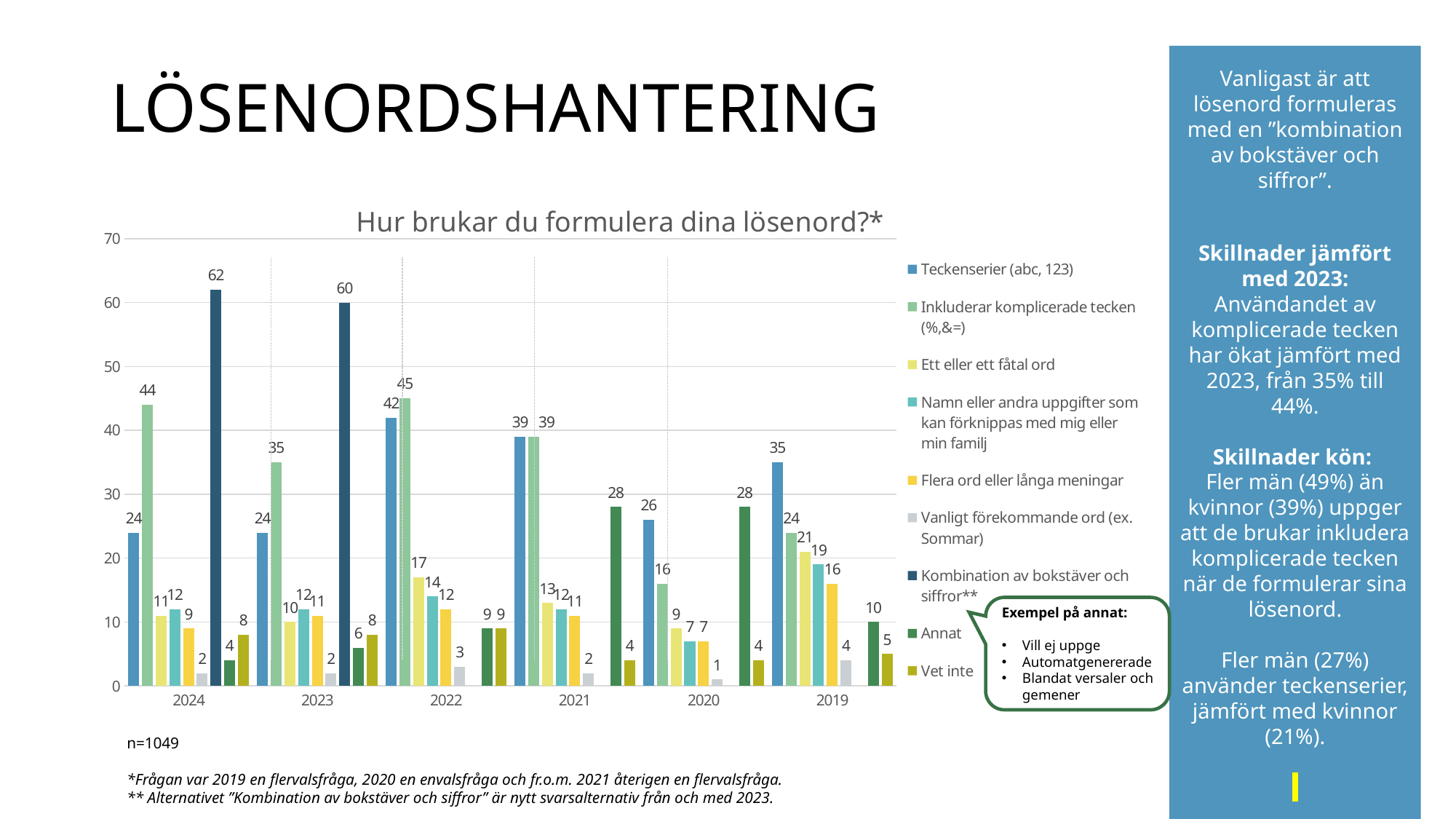
What is the value for 'Inkluderar komplicerade tecken' in 2023? 35 What is the title of the chart? Hur brukar du formulera dina lösenord?* Is the value for 'Kombination av bokstäver och siffror' in 2023 greater or less than 50? greater What type of chart is shown on the slide? bar chart How many series does the legend list? 9 Which year has the highest value for 'Annat'? 2021 and 2020 (28) What is the difference between 'Inkluderar komplicerade tecken' in 2024 and in 2023? 9 Which year has the lowest value for 'Vanligt förekommande ord'? 2020 What is the value for 'Kombination av bokstäver och siffror' in 2024? 62 What is the value for 'Teckenserier' in 2022? 42 How many years are shown along the x axis? 6 Which is larger in 2019: 'Teckenserier' or 'Inkluderar komplicerade tecken'? Teckenserier